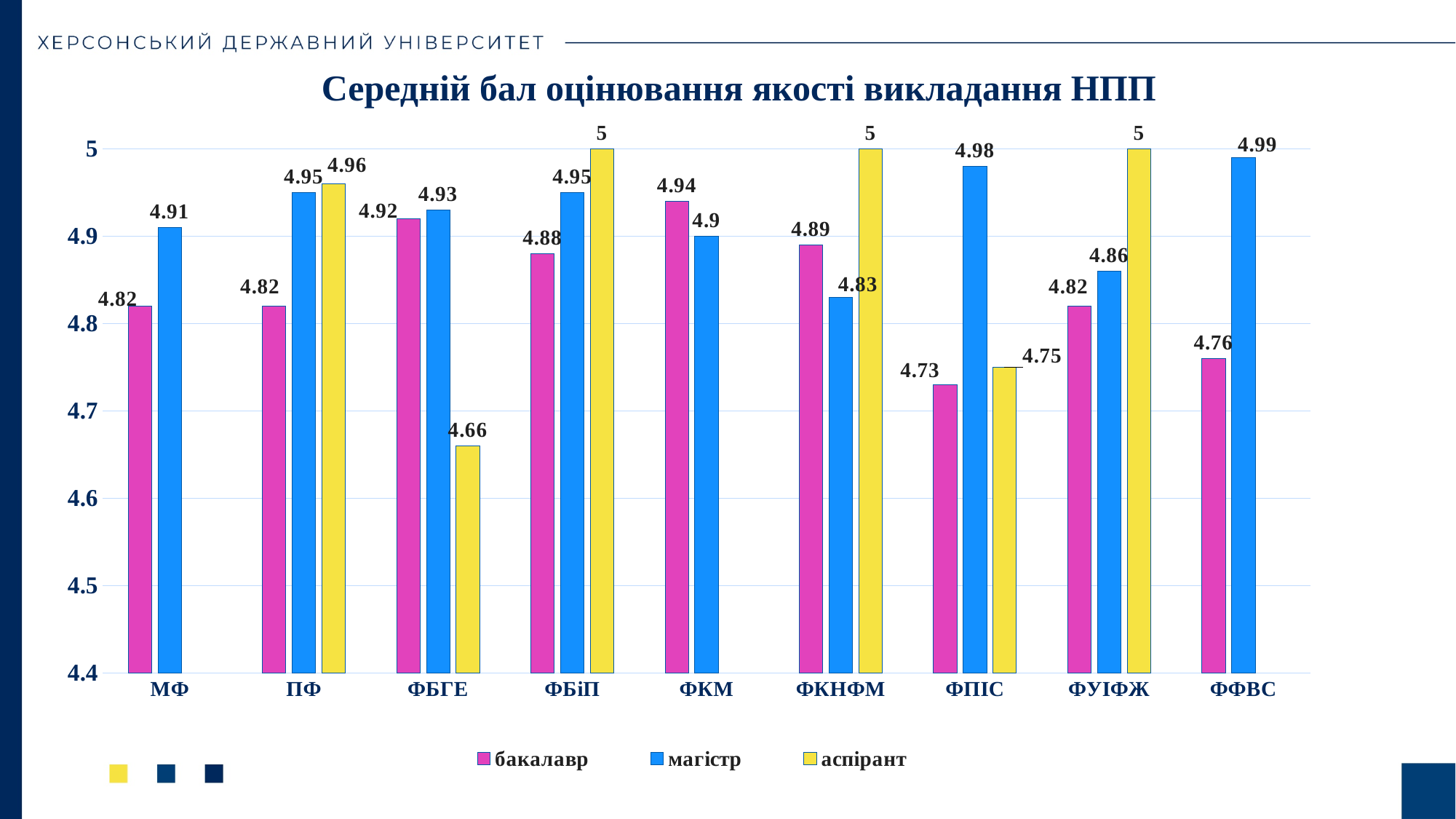
What is the difference between the магістр and бакалавр values at ФПІС? 0.25 How many series does the legend list? 3 At ФКНФМ, which is larger: бакалавр or магістр? бакалавр Which category has the highest бакалавр value? ФКМ How many categories are shown on the x axis? 9 What is the difference between the магістр and аспірант values at ФБГЕ? 0.27 What is the value for бакалавр at ФКМ? 4.94 What kind of chart is shown on the slide? bar chart Which category has the lowest аспірант value? ФБГЕ Which category has the lowest бакалавр value? ФПІС What is the value for аспірант at ФБГЕ? 4.66 What is the value for магістр at ФПІС? 4.98